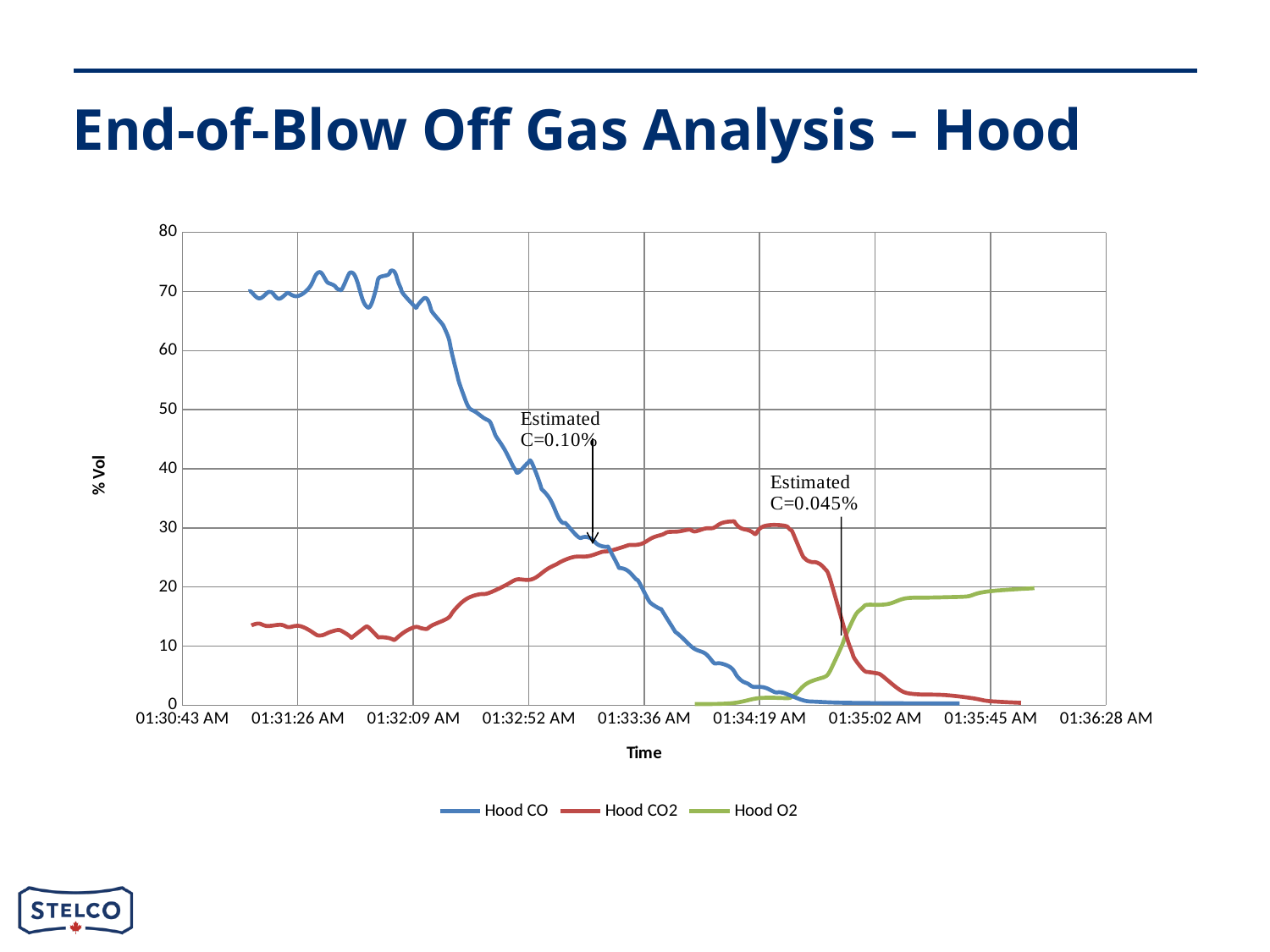
Is the value for Hood O2 at 01:35:45 AM greater or less than 10? greater Does the Hood O2 series rise or fall over time along the x axis? rise What is the title of the vertical axis? % Vol Which series reaches the highest value on the chart? Hood CO How many series does the legend list? 3 What kind of chart is shown on the slide? line chart Does the Hood CO series rise or fall over time along the x axis? fall At 01:31:26 AM, which series has the higher value, Hood CO or Hood CO2? Hood CO Is the value for Hood CO at 01:31:26 AM greater or less than 60? greater Is the value for Hood CO at 01:35:02 AM greater or less than 10? less At 01:35:45 AM, which series has the higher value, Hood O2 or Hood CO2? Hood O2